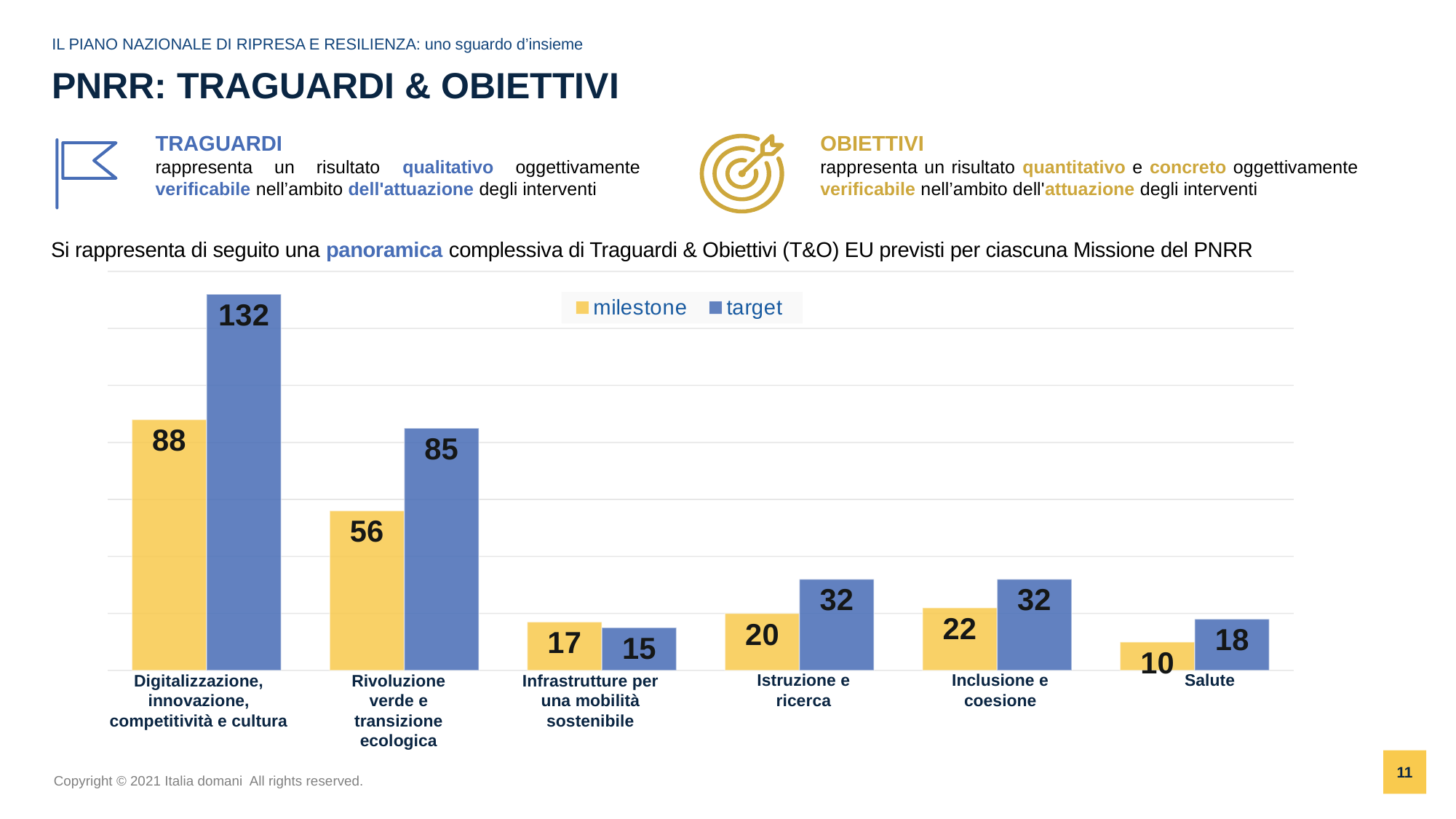
For Infrastrutture per una mobilità sostenibile, which is larger: the milestone value or the target value? milestone What kind of chart is shown on the slide? bar chart Which series is shown in yellow in the legend? milestone What is the difference between the target and milestone values for Digitalizzazione, innovazione, competitività e cultura? 44 What is the difference between the milestone values for Inclusione e coesione and Istruzione e ricerca? 2 Which category has the lowest milestone value? Salute How many series does the legend list? 2 What is the milestone value for Salute? 10 How many categories are shown on the x axis? 6 What is the milestone value for Digitalizzazione, innovazione, competitività e cultura? 88 What is the target value for Rivoluzione verde e transizione ecologica? 85 Which category has the highest target value? Digitalizzazione, innovazione, competitività e cultura